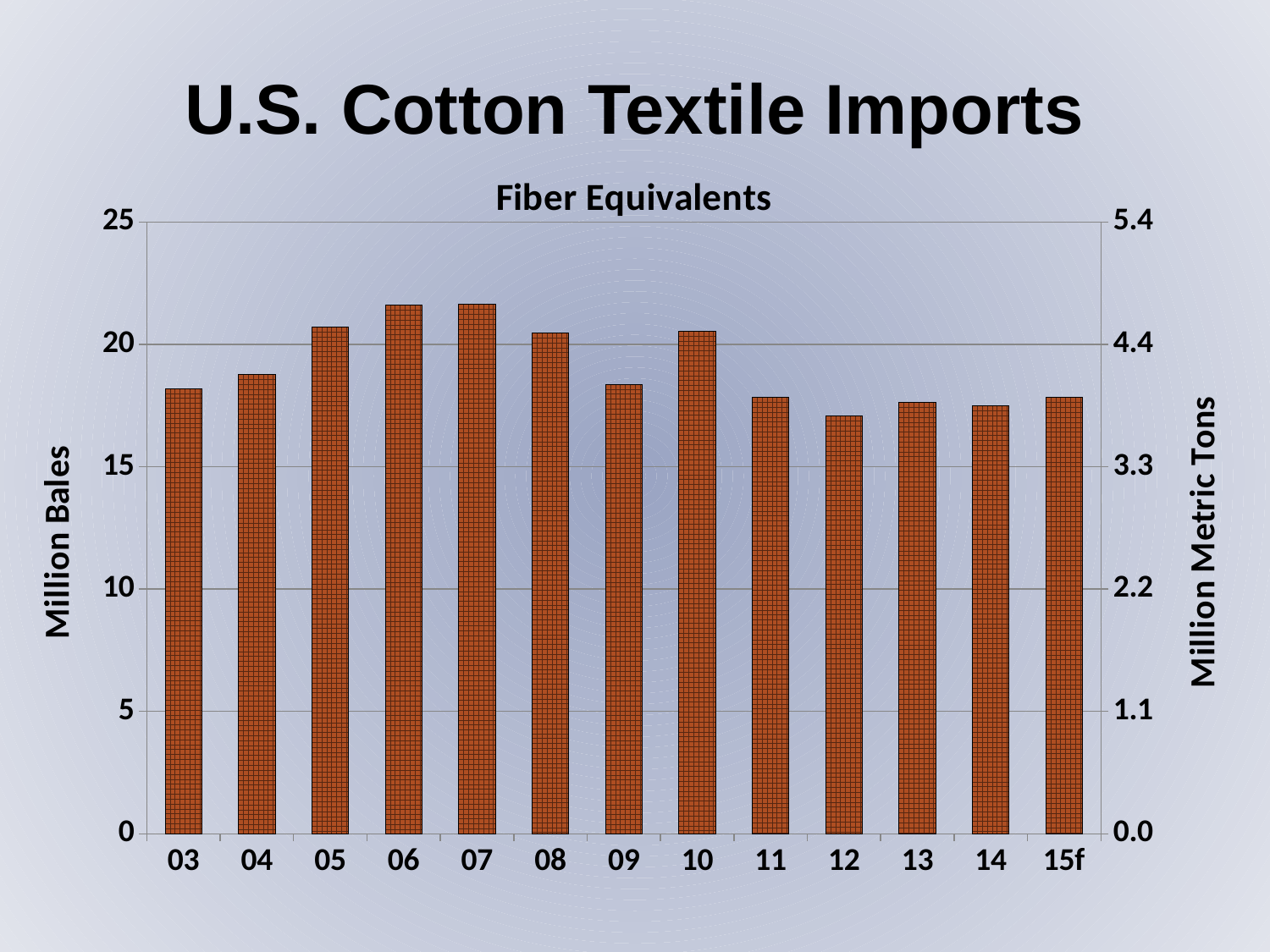
What kind of chart is shown on the slide? bar chart Which is larger, the value for 06 or the value for 12? 06 Is the value for 11 greater or less than 15 million bales? greater How many years (bars) are plotted on the chart? 13 Is the value for 05 greater or less than 20 million bales? greater Which year has the lowest value on the chart? 12 Do the values rise or fall from 10 to 12? fall Is the value for 03 greater or less than 20 million bales? less What is the label on the right vertical axis? Million Metric Tons What is the label on the left vertical axis? Million Bales Which is larger, the value for 05 or the value for 09? 05